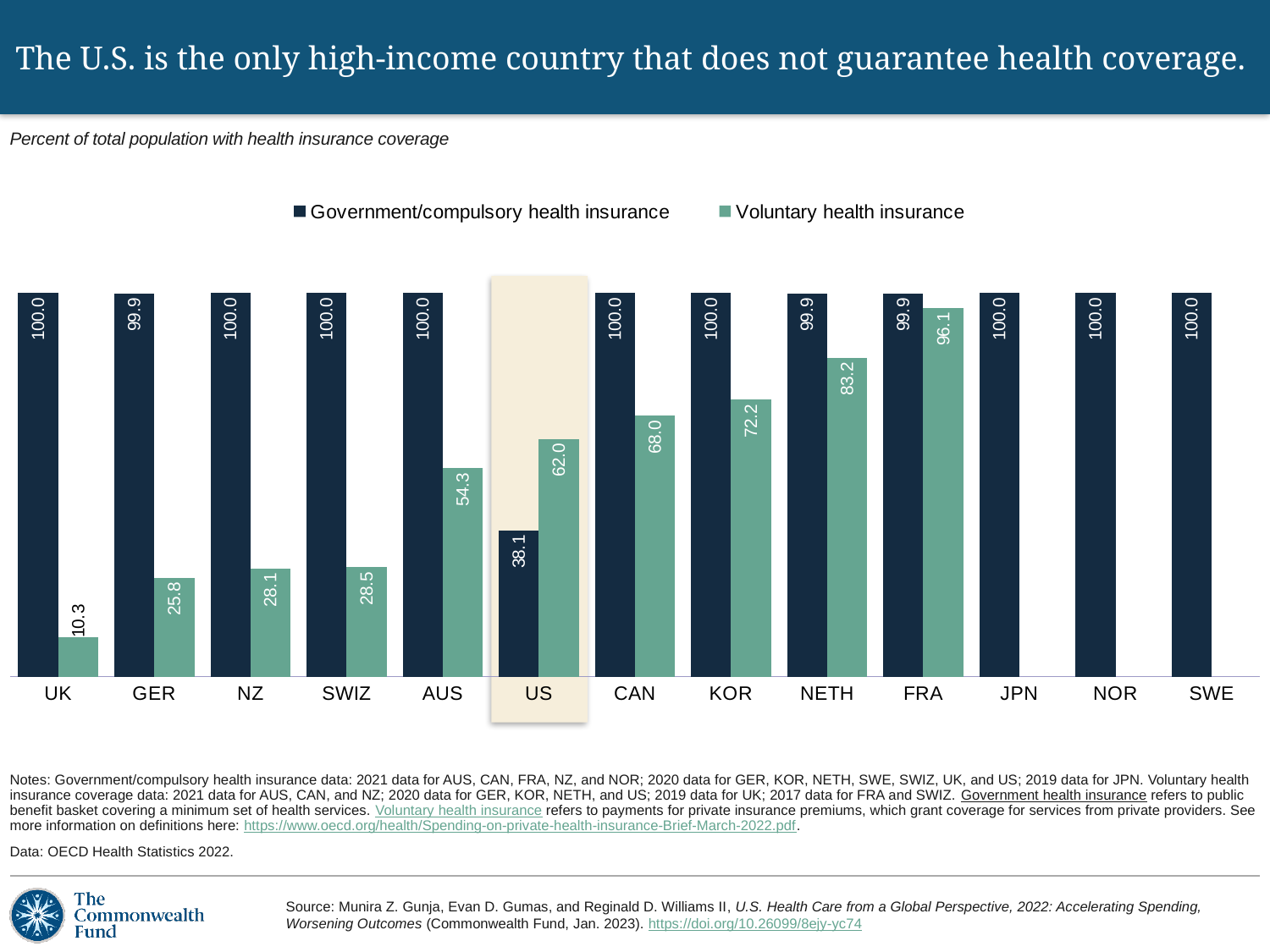
Which country has the highest Voluntary health insurance value? FRA How many countries are shown on the x axis? 13 What is the Government/compulsory health insurance value for Germany (GER)? 99.9 What is the difference between the Voluntary health insurance values for CAN and AUS? 13.7 What is the Voluntary health insurance value for the UK? 10.3 What is the Voluntary health insurance value for the Netherlands (NETH)? 83.2 What is the Government/compulsory health insurance value for the US? 38.1 Which country has the lowest Government/compulsory health insurance value? US How many series does the legend list? 2 Which country is highlighted with a shaded background on the chart? US What kind of chart is shown on the slide? Bar chart Which is larger, the Voluntary health insurance value for KOR or for CAN? KOR